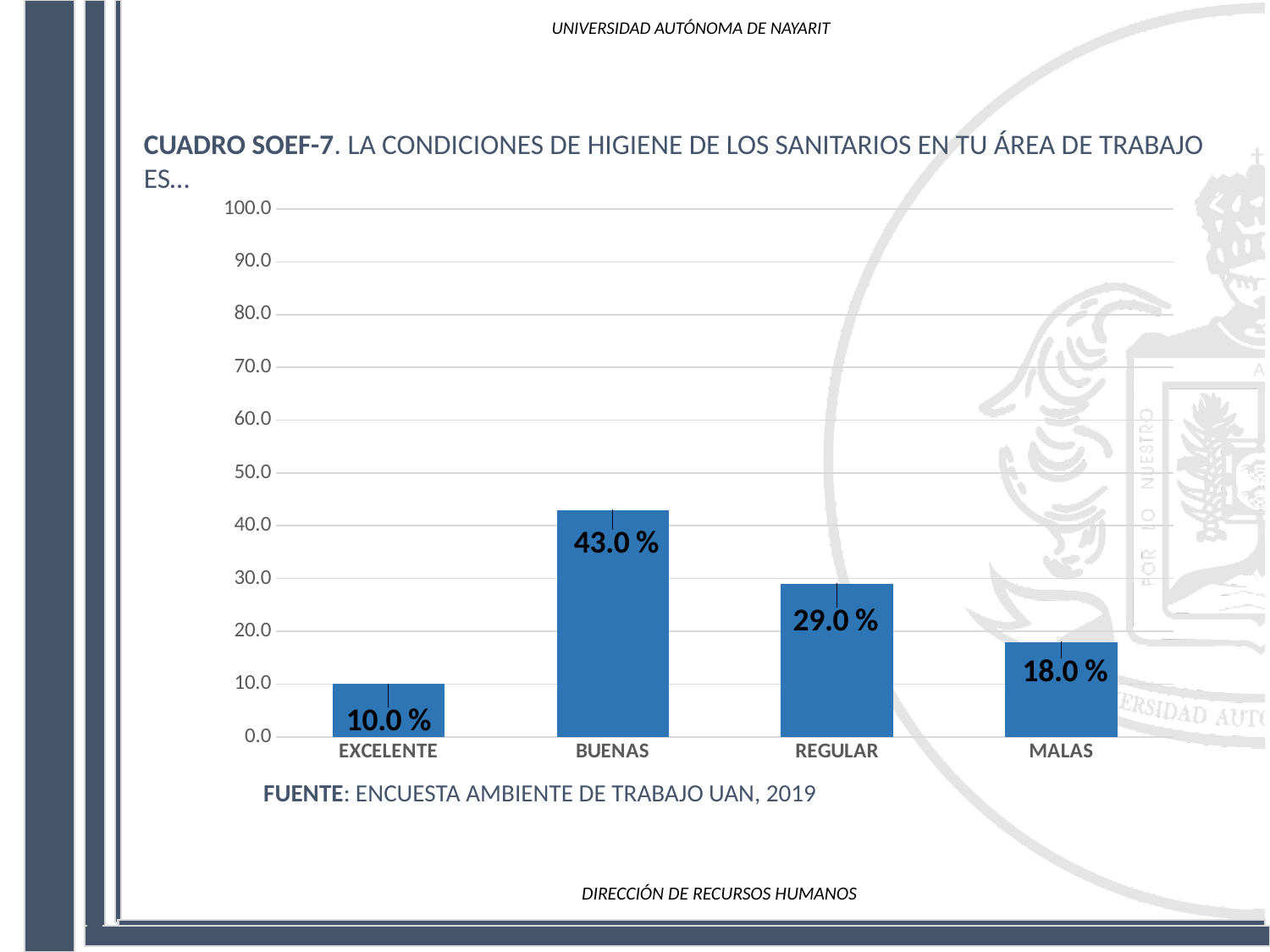
What is the value for MALAS? 18.0 % What is the value for BUENAS? 43.0 % Which category has the highest value? BUENAS Which category has the lowest value? EXCELENTE What kind of chart is shown on the slide? bar chart What is the difference between the values for BUENAS and REGULAR? 14.0 % What is the value for EXCELENTE? 10.0 % What is the value for REGULAR? 29.0 % Which is larger, the value for REGULAR or the value for MALAS? REGULAR How many categories are shown on the x axis? 4 What is the source cited below the chart? ENCUESTA AMBIENTE DE TRABAJO UAN, 2019 Is the value for BUENAS greater or less than 40.0? greater